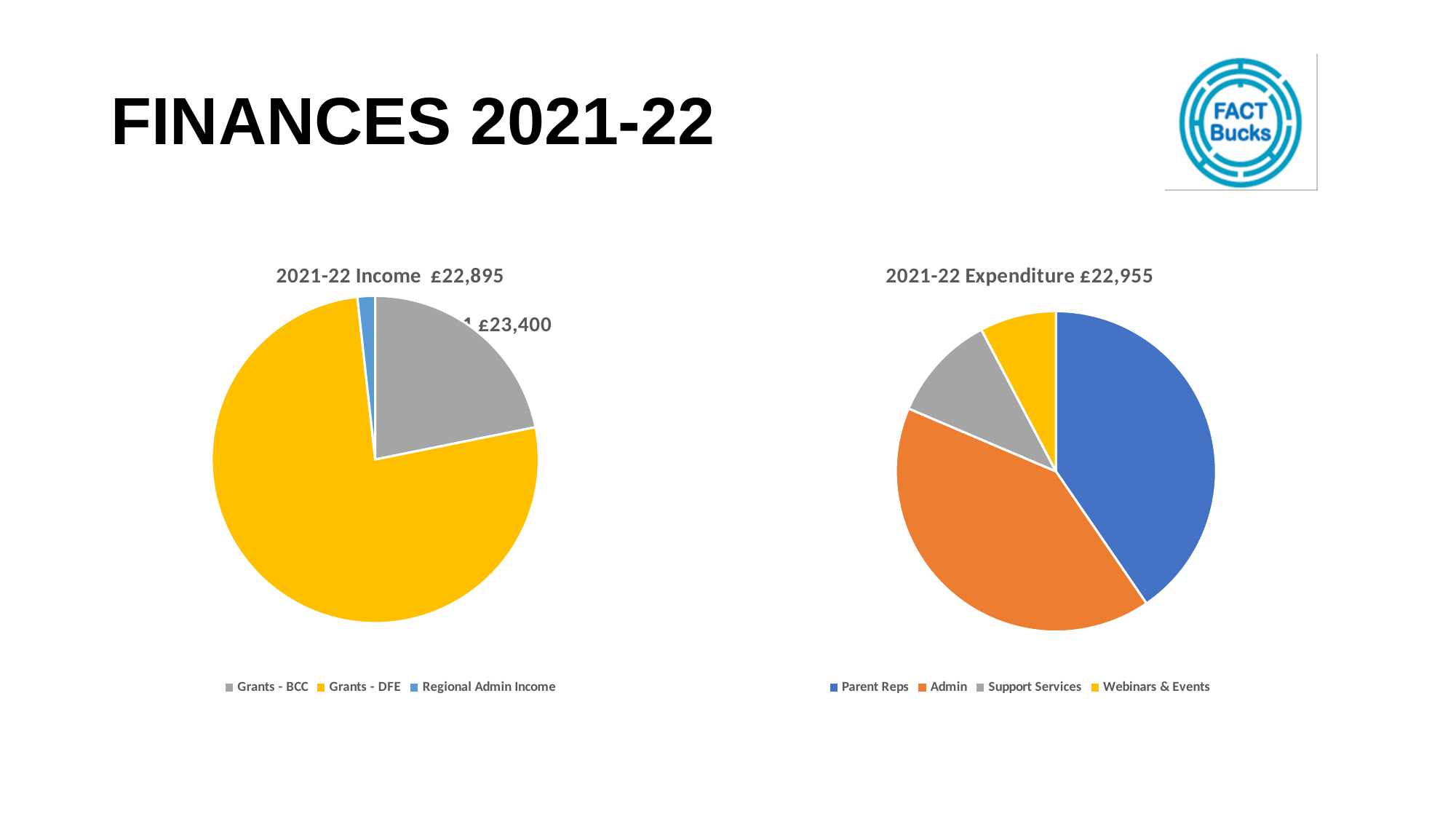
What total expenditure figure is shown in the title of the right chart? £22,955 In the 2021-22 Income chart, which is larger: Grants - BCC or Grants - DFE? Grants - DFE In the 2021-22 Income chart, which category has the largest slice? Grants - DFE In the 2021-22 Income chart, how many categories does the legend list? 3 In the 2021-22 Expenditure chart, which is larger: Parent Reps or Support Services? Parent Reps In the 2021-22 Expenditure chart, which category has the smallest slice? Webinars & Events In the 2021-22 Expenditure chart, which is larger: Admin or Webinars & Events? Admin In the 2021-22 Expenditure chart, how many categories does the legend list? 4 What kind of chart is the 2021-22 Expenditure chart? Pie chart In the 2021-22 Income chart, which category has the smallest slice? Regional Admin Income What kind of chart is the 2021-22 Income chart? Pie chart What total income figure is shown in the title of the left chart? £22,895